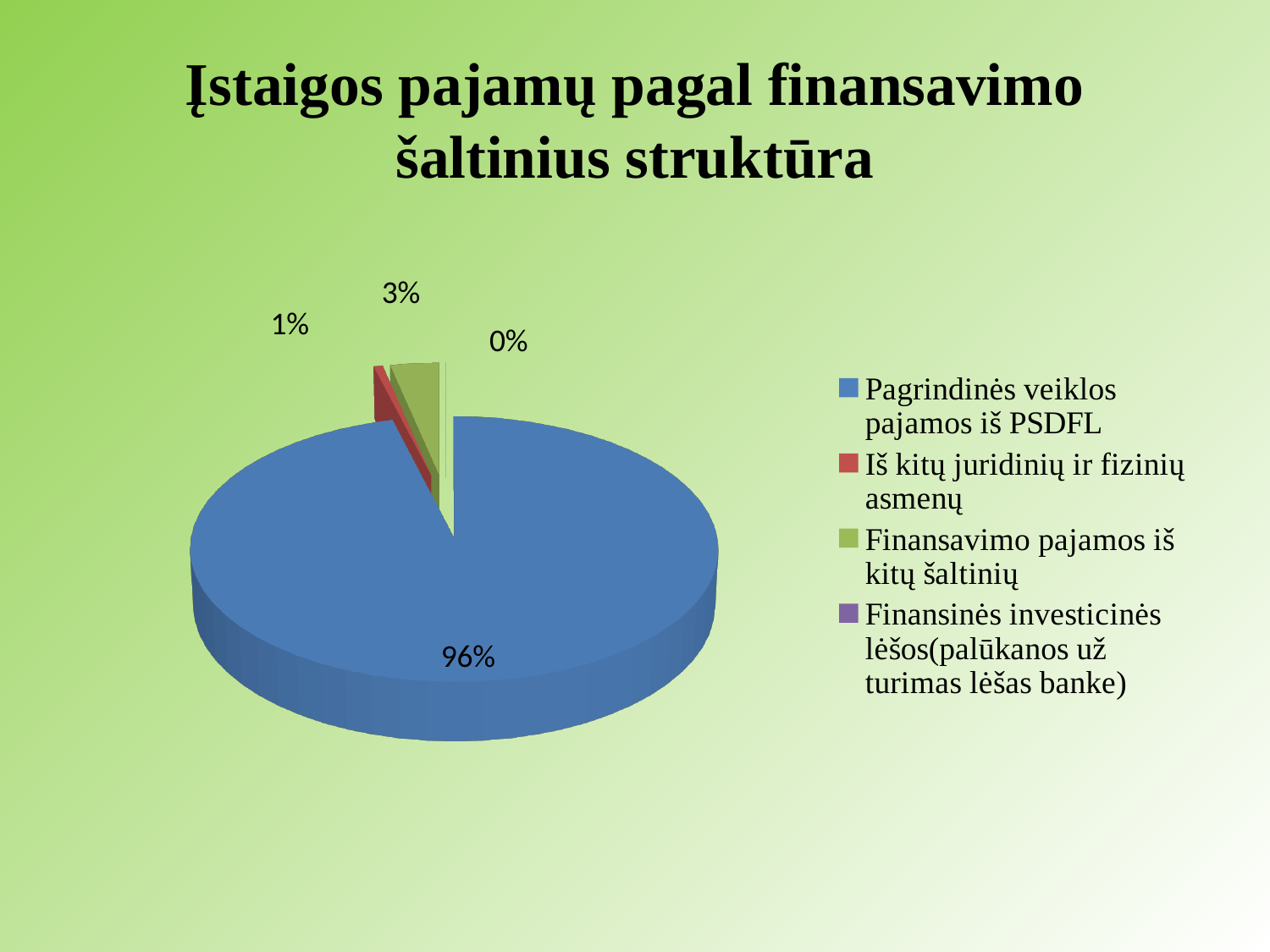
What kind of chart is shown on the slide? pie chart What is the title of the chart slide? Įstaigos pajamų pagal finansavimo šaltinius struktūra What is the difference in percentage points between the share of "Pagrindinės veiklos pajamos iš PSDFL" and "Finansavimo pajamos iš kitų šaltinių"? 93 percentage points How many categories does the legend list? 4 What share of the pie does "Finansavimo pajamos iš kitų šaltinių" have? 3% What share of the pie does "Pagrindinės veiklos pajamos iš PSDFL" have? 96% What colour is the slice for "Pagrindinės veiklos pajamos iš PSDFL"? blue Which has a larger share: "Finansavimo pajamos iš kitų šaltinių" or "Iš kitų juridinių ir fizinių asmenų"? Finansavimo pajamos iš kitų šaltinių What share of the pie does "Finansinės investicinės lėšos (palūkanos už turimas lėšas banke)" have? 0% Which category has the smallest share of the pie? Finansinės investicinės lėšos (palūkanos už turimas lėšas banke) Which category has the largest share of the pie? Pagrindinės veiklos pajamos iš PSDFL